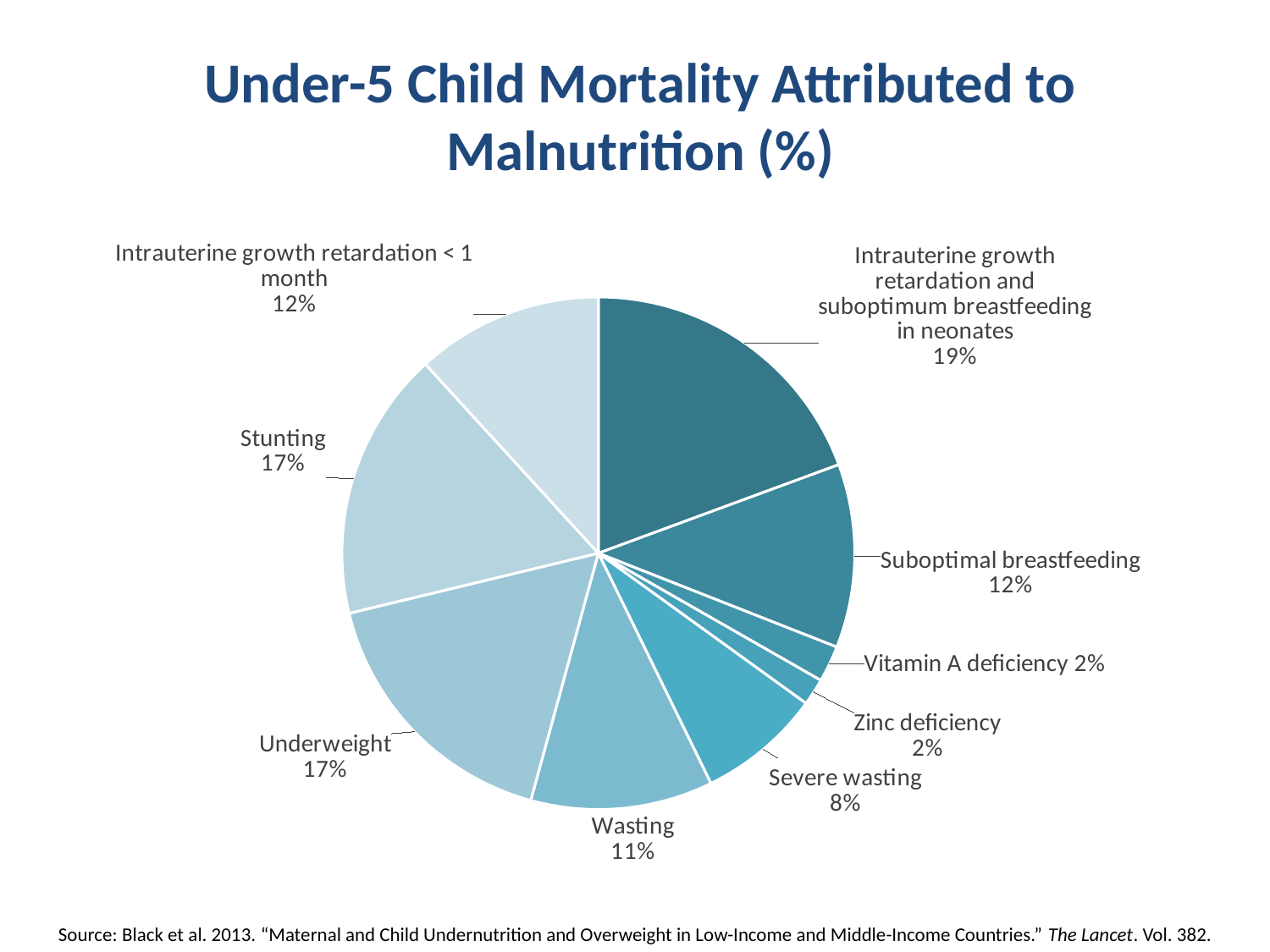
What kind of chart is shown on the slide? pie chart Which category has the largest slice of the pie? Intrauterine growth retardation and suboptimum breastfeeding in neonates How many slices does the pie chart have? 9 What percentage is shown for Zinc deficiency? 2% What share of under-5 child mortality is attributed to Stunting? 17% What is the percentage for the largest slice of the pie? 19% What is the title of the chart? Under-5 Child Mortality Attributed to Malnutrition (%) What percentage is shown for Suboptimal breastfeeding? 12% Which is larger, the slice for Wasting or the slice for Severe wasting? Wasting What is the difference in percentage points between Intrauterine growth retardation and suboptimum breastfeeding in neonates and Suboptimal breastfeeding? 7 What is the difference in percentage points between Underweight and Wasting? 6 What percentage is shown for Severe wasting? 8%